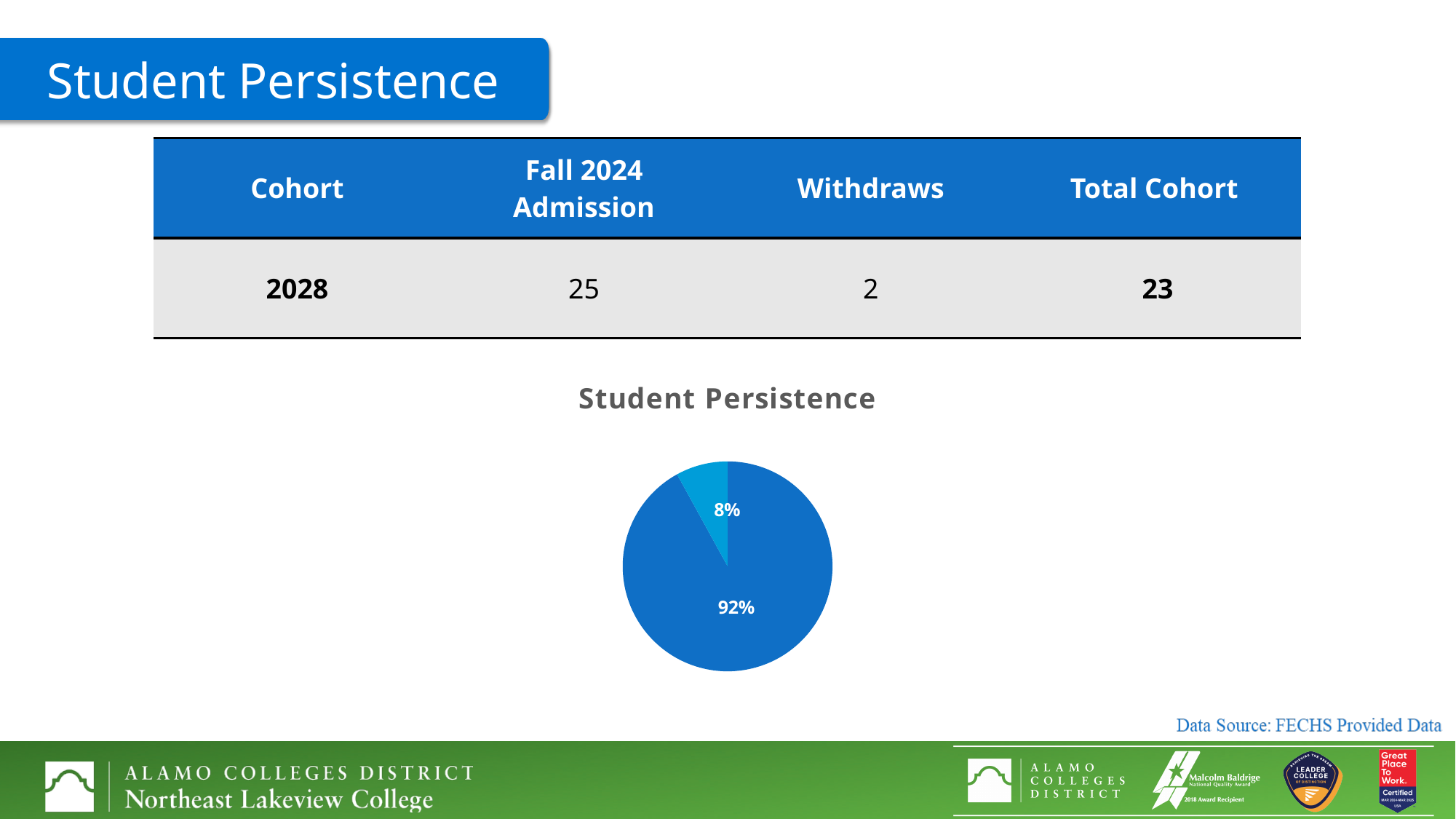
How many slices does the pie chart have? 2 What percentage is labelled on the light blue slice of the pie chart? 8% Does the pie chart include a legend? No What percentage is shown on the largest slice of the pie chart? 92% Which slice is larger in the pie chart, the dark blue slice or the light blue slice? the dark blue slice What is the difference in percentage points between the two slices of the pie chart? 84 What kind of chart is shown on the slide? pie chart What percentage is labelled on the dark blue slice of the pie chart? 92% What percentage is shown on the smallest slice of the pie chart? 8% What is the title of the chart? Student Persistence